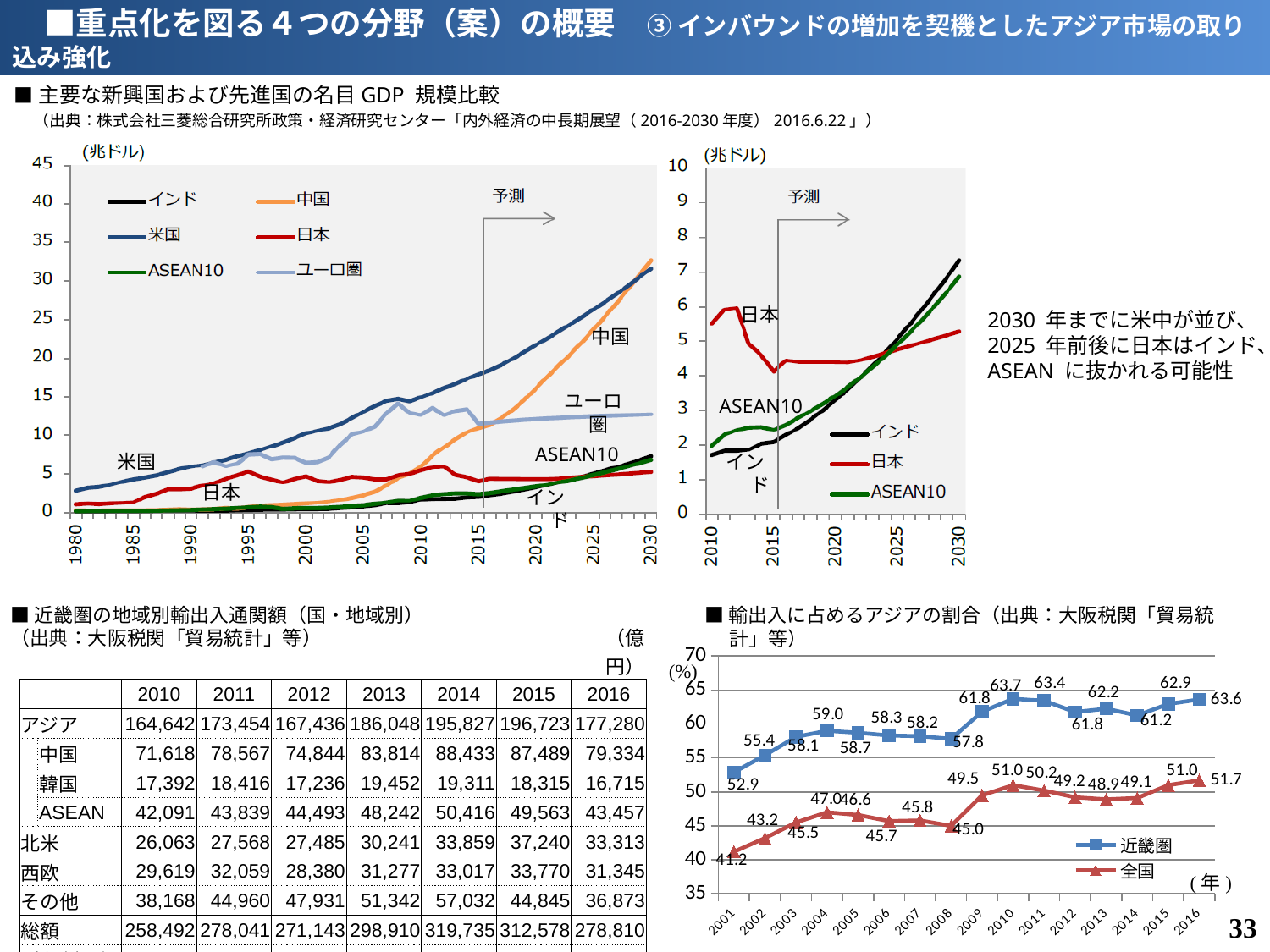
In the top-right chart (インド・日本・ASEAN10), is the value for インド in 2030 greater or less than 6? greater In the top-left chart (主要な新興国および先進国の名目GDP規模比較), is the value for 米国 in 2030 greater or less than 25? greater In the bottom-right chart (輸出入に占めるアジアの割合), in which year is the 近畿圏 value highest? 2010 In the bottom-right chart (輸出入に占めるアジアの割合), how many years are shown on the x axis? 16 In the bottom-right chart (輸出入に占めるアジアの割合), what is the value for 近畿圏 in 2010? 63.7 In the top-left chart (主要な新興国および先進国の名目GDP規模比較), how many series does the legend list? 6 In the top-right chart (インド・日本・ASEAN10), does the value for インド rise or fall from 2015 to 2030? rise What kind of chart is the top-left chart (主要な新興国および先進国の名目GDP規模比較)? line chart In the bottom-right chart (輸出入に占めるアジアの割合), in which year is the 全国 value lowest? 2001 In the bottom-right chart (輸出入に占めるアジアの割合), what is the value for 全国 in 2001? 41.2 In the bottom-right chart (輸出入に占めるアジアの割合), what is the difference between the 近畿圏 and 全国 values in 2016? 11.9 In the bottom-right chart (輸出入に占めるアジアの割合), how many series does the legend list? 2